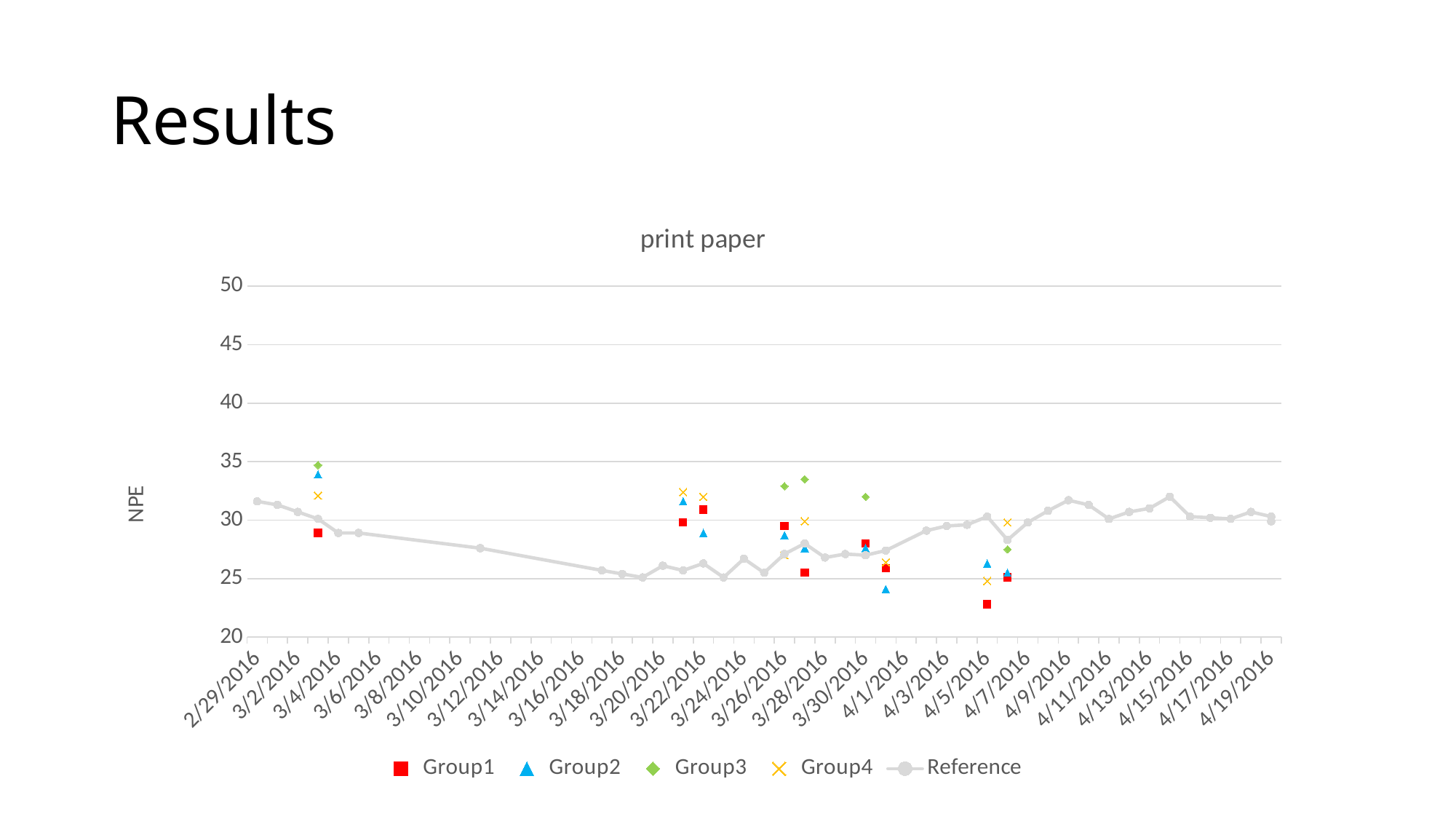
Near 3/22/2016, which series has the higher value, Group4 or Group1? Group4 Is the lowest Group1 value, near 4/5/2016, greater or less than 25? less Is the Reference value on 2/29/2016 greater or less than 30? greater What kind of chart is shown on the slide? line chart How many series does the legend list? 5 Is the Reference value on 3/19/2016 greater or less than 30? less Does the Reference line rise or fall between 4/1/2016 and 4/9/2016? rise What is the label on the vertical axis? NPE Does the Reference line rise or fall between 2/29/2016 and 3/19/2016? fall What is the title of the chart? print paper Near 3/4/2016, which series has the higher value, Group3 or Group1? Group3